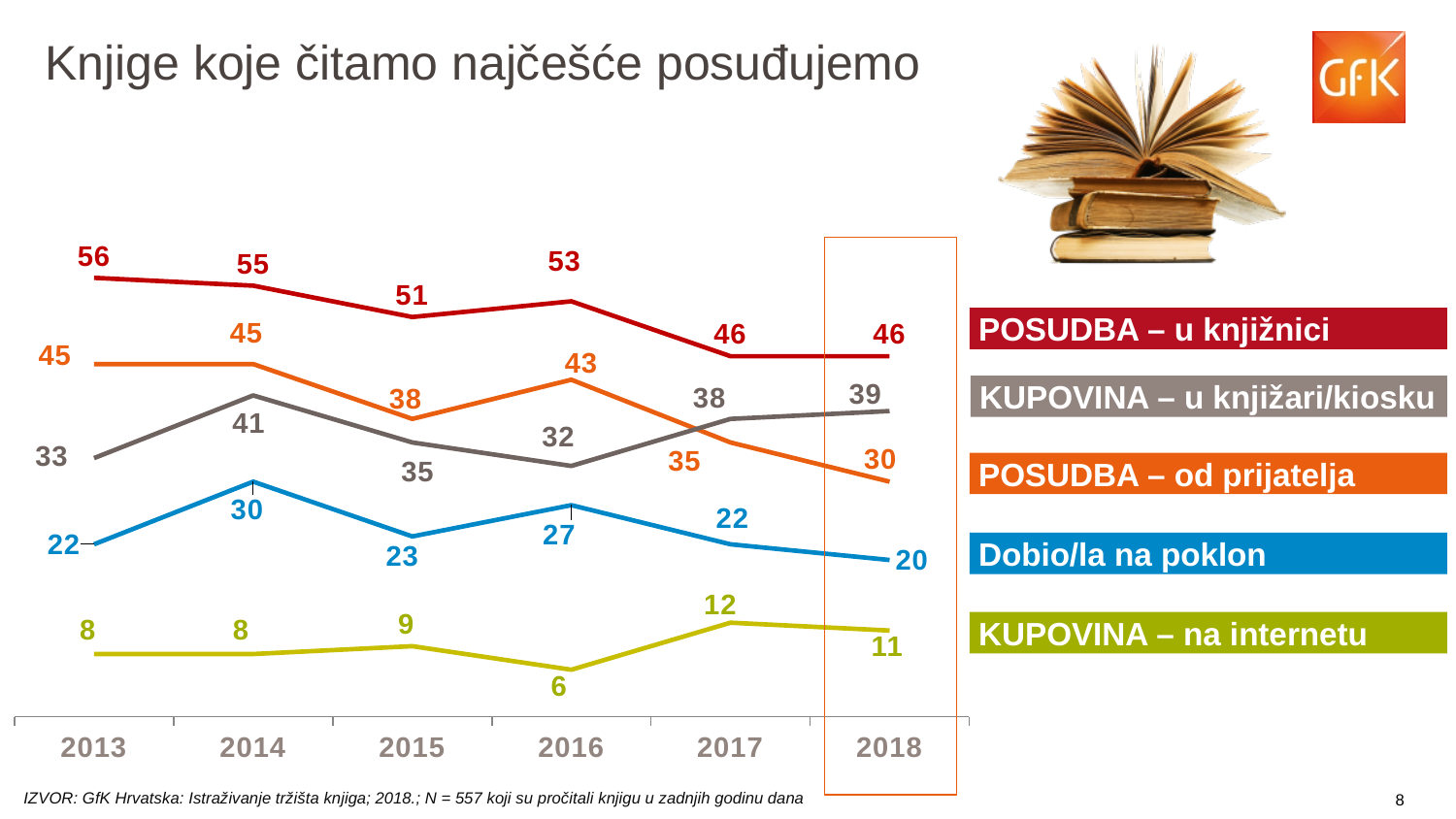
How many series does the legend on the right list? 5 What type of chart is shown on the slide? line chart Does the value for POSUDBA – u knjižnici rise or fall from 2013 to 2018? fall What is the value for KUPOVINA – u knjižari/kiosku in 2018? 39 In which year is KUPOVINA – na internetu highest? 2017 What is the difference between POSUDBA – u knjižnici and POSUDBA – od prijatelja in 2018? 16 Which is larger in 2017: KUPOVINA – u knjižari/kiosku or POSUDBA – od prijatelja? KUPOVINA – u knjižari/kiosku How many years are shown on the x axis? 6 In which year is POSUDBA – od prijatelja lowest? 2018 What is the value for Dobio/la na poklon in 2014? 30 What is the value for POSUDBA – u knjižnici in 2013? 56 What is the value for KUPOVINA – na internetu in 2016? 6